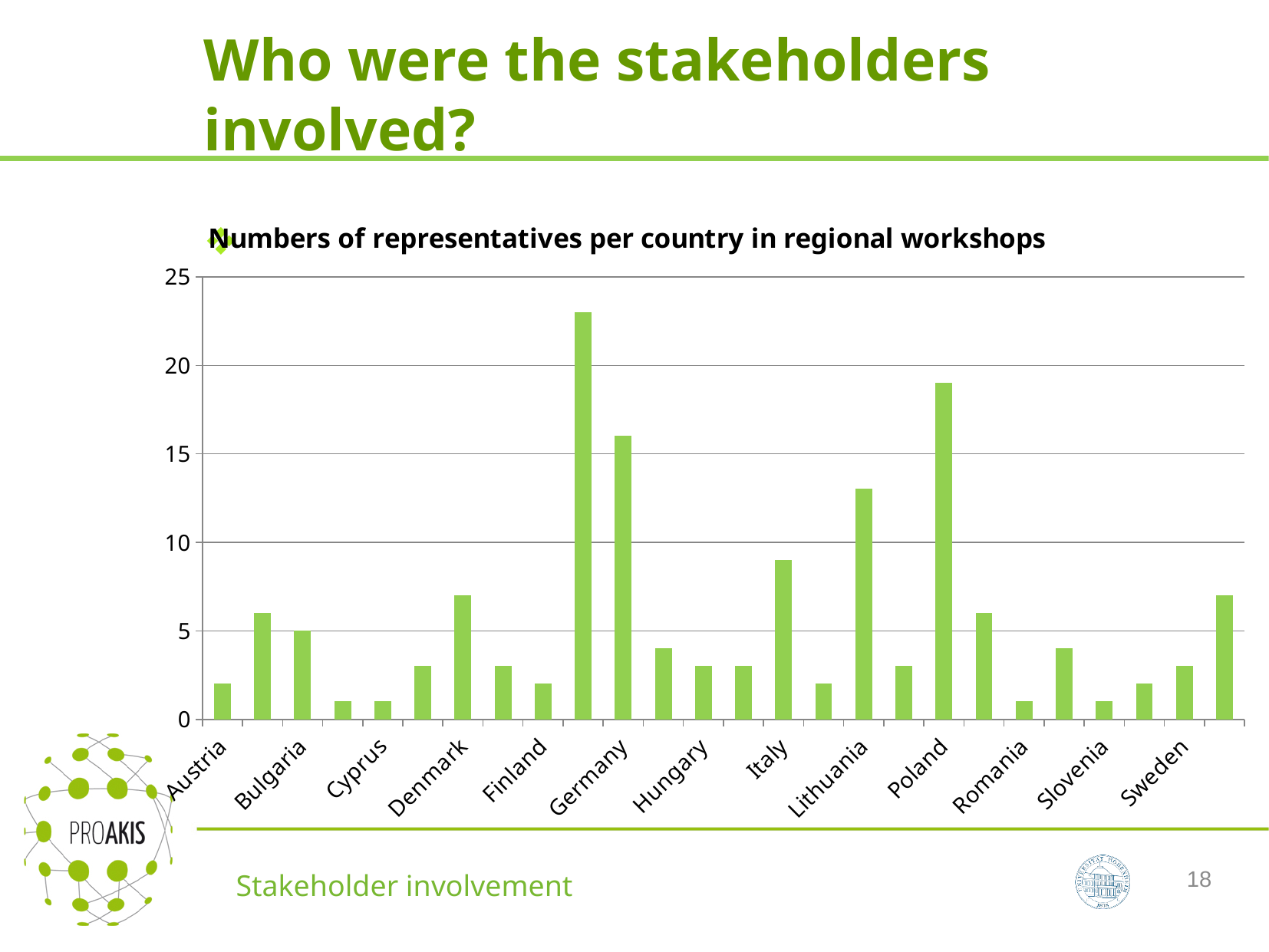
Is the value for Austria greater or less than 5? less Which has a higher value, Poland or Germany? Poland How many country labels are shown on the x axis? 13 Is the value for Lithuania greater or less than 10? greater Is the value for Poland greater or less than 15? greater What is the title of the chart? Numbers of representatives per country in regional workshops What kind of chart is shown on the slide? bar chart Which has a higher value, Lithuania or Italy? Lithuania